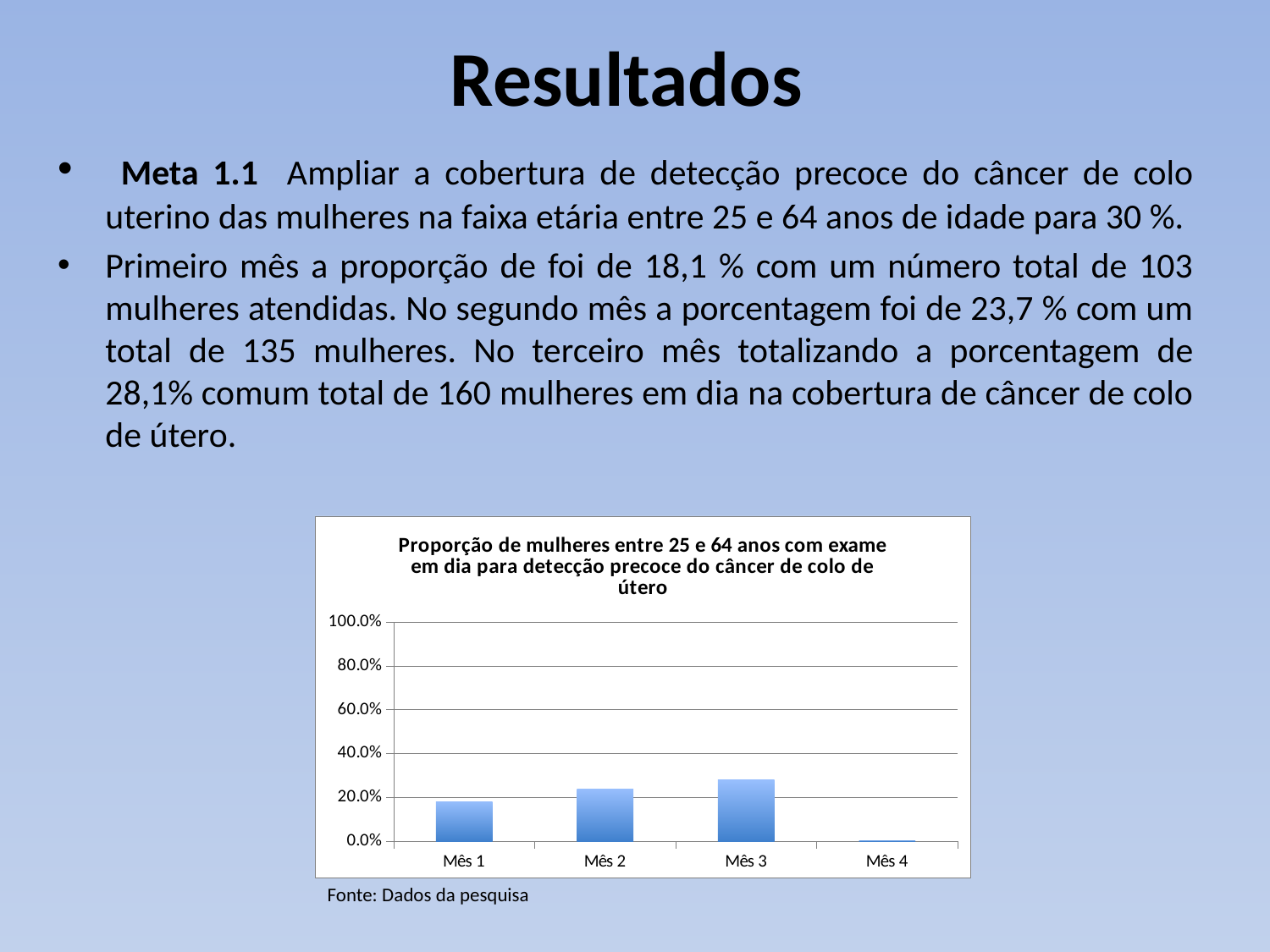
Is the value for Mês 2 greater or less than 20.0%? greater Which month has the lowest bar in the chart? Mês 4 Is the value for Mês 1 greater or less than 20.0%? less Is the value for Mês 3 greater or less than 20.0%? greater What is the title of the chart? Proporção de mulheres entre 25 e 64 anos com exame em dia para detecção precoce do câncer de colo de útero What is the maximum value shown on the chart's vertical axis? 100.0% How many categories (months) are shown on the x axis of the chart? 4 What kind of chart is shown on the slide? bar chart Do the values rise or fall from Mês 1 to Mês 3? rise Which month has the highest bar in the chart? Mês 3 Which is larger, the value for Mês 1 or the value for Mês 3? Mês 3